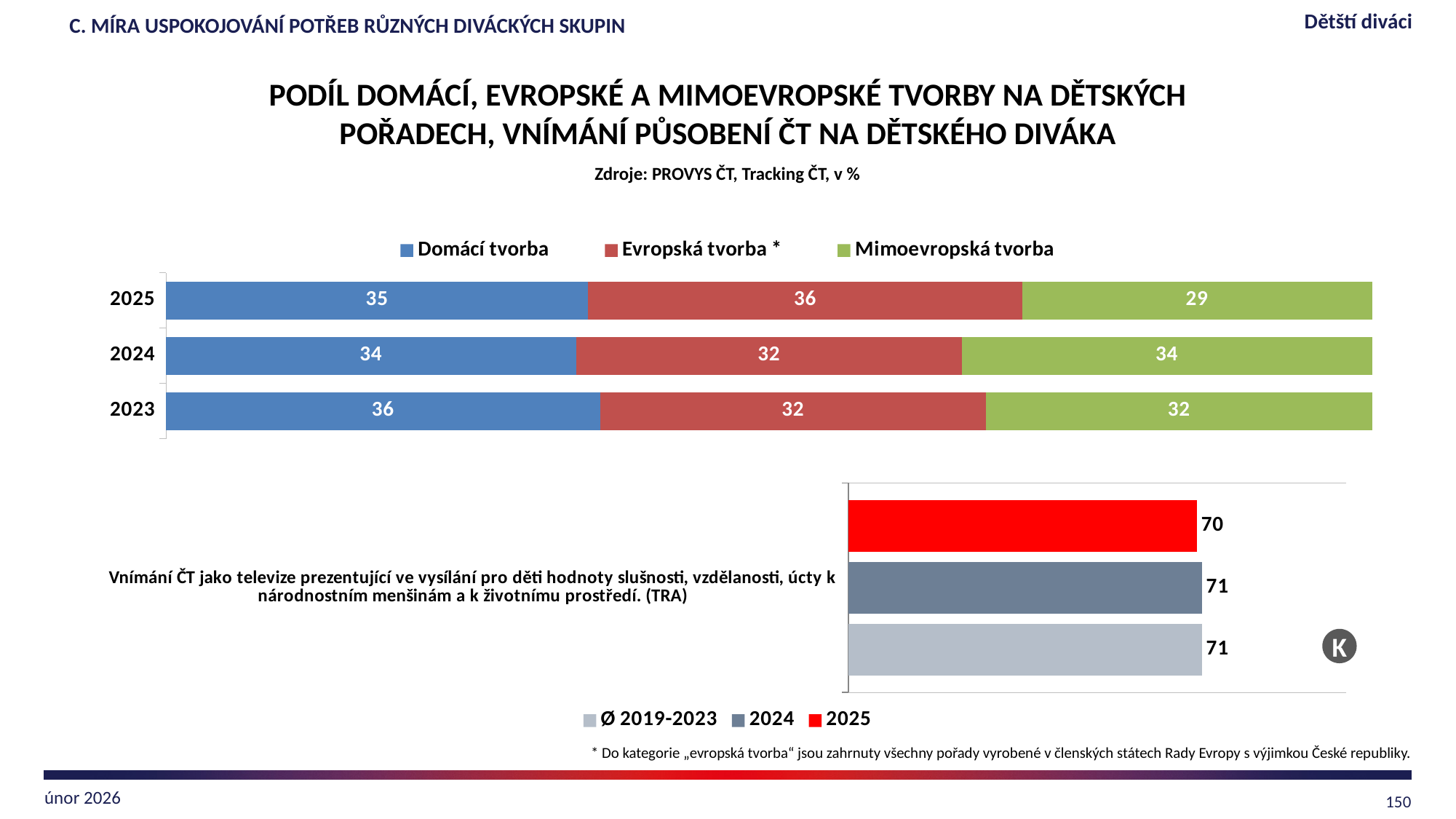
In the top stacked bar chart, what is the total of the 2025 bar? 100 How many series does the legend of the top stacked bar chart list? 3 In the top stacked bar chart, what is the value for Mimoevropská tvorba in 2023? 32 In the top stacked bar chart, what is the difference between Evropská tvorba in 2025 and in 2024? 4 In the bottom chart (Vnímání ČT jako televize prezentující ve vysílání pro děti hodnoty slušnosti...), what is the value for Ø 2019-2023? 71 What kind of chart is the bottom chart on the slide? bar chart In the top stacked bar chart, what is the value for Evropská tvorba in 2024? 32 In the bottom chart (Vnímání ČT jako televize prezentující ve vysílání pro děti hodnoty slušnosti...), what is the value for 2025? 70 In the top stacked bar chart, which year has the highest value for Mimoevropská tvorba? 2024 In the top stacked bar chart, what is the value for Domácí tvorba in 2025? 35 In the top stacked bar chart, which year has the lowest value for Domácí tvorba? 2024 In the bottom chart (Vnímání ČT jako televize prezentující ve vysílání pro děti hodnoty slušnosti...), which is larger, the value for 2024 or for 2025? 2024